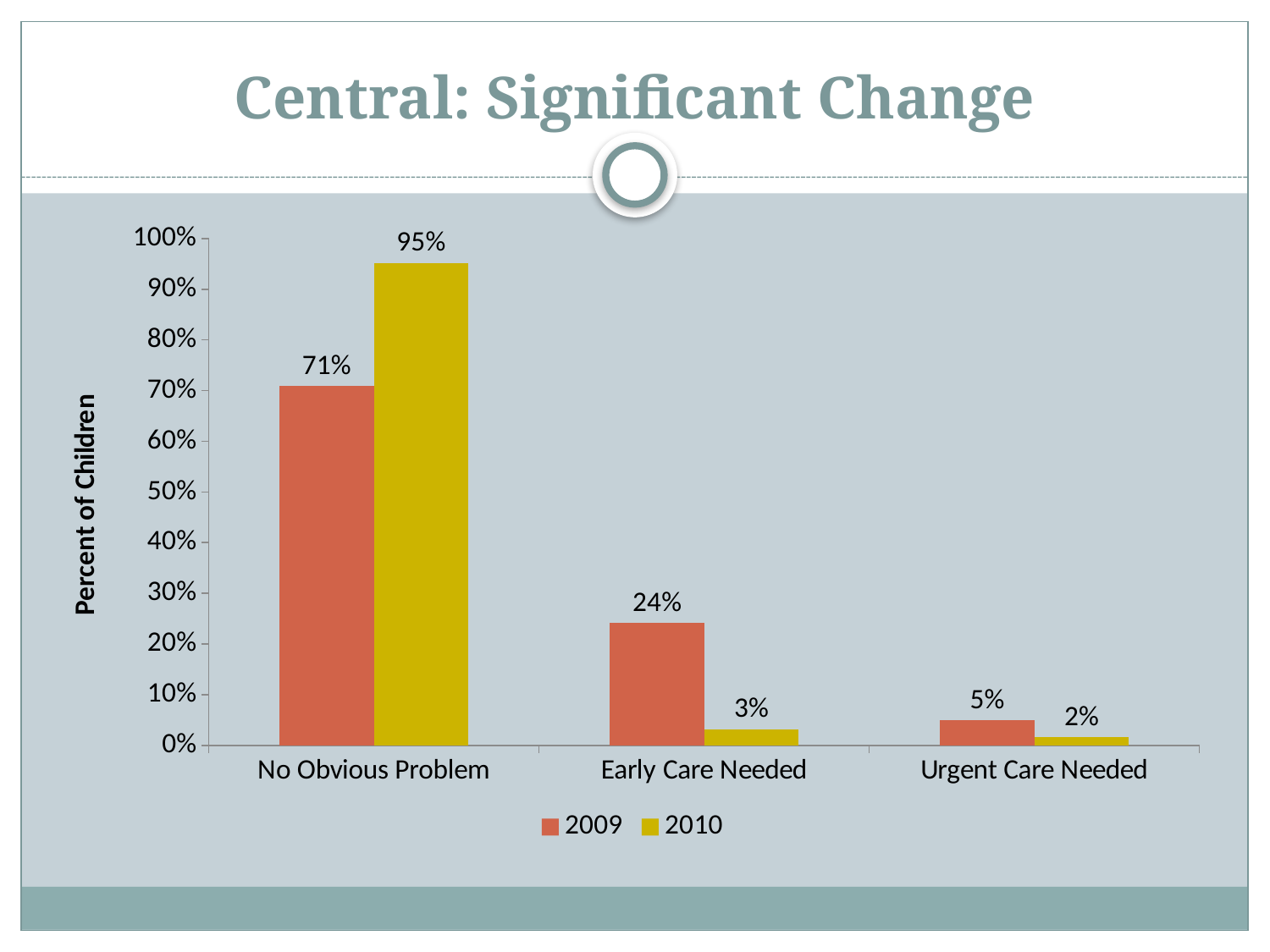
What is the 2009 value for Urgent Care Needed? 5% What is the 2010 value for Early Care Needed? 3% What is the 2009 value for Early Care Needed? 24% How many categories are shown on the x axis? 3 How many series does the legend list? 2 What is the 2010 value for No Obvious Problem? 95% Which category has the highest 2009 value? No Obvious Problem Which category has the lowest 2010 value? Urgent Care Needed What is the label of the vertical axis? Percent of Children Which is larger for Early Care Needed, the 2009 value or the 2010 value? 2009 What is the difference between the 2010 and 2009 values for No Obvious Problem? 24% What kind of chart is shown on the slide? Bar chart